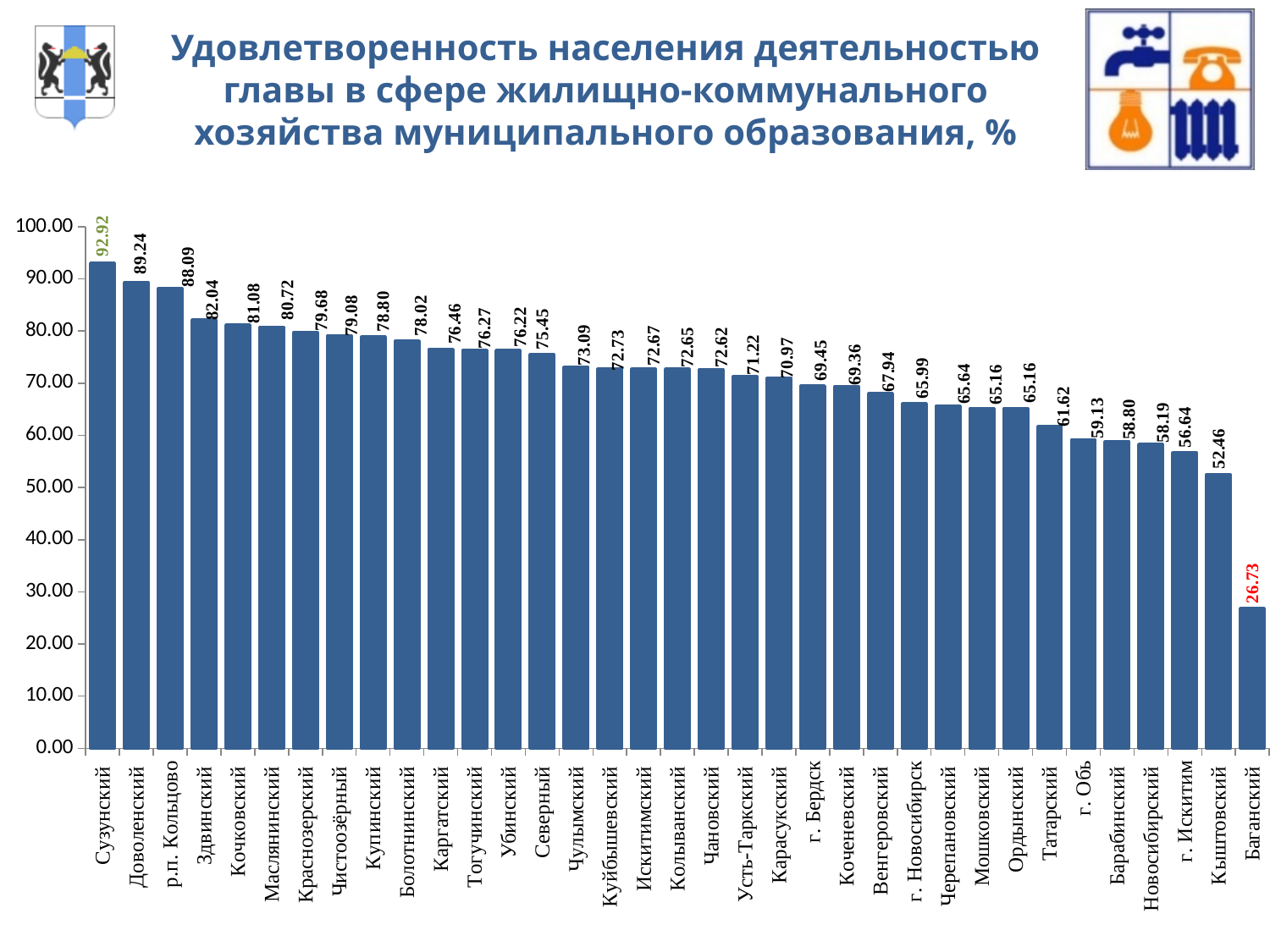
What kind of chart is shown on the slide? bar chart What is the difference between the values for Доволенский and р.п. Кольцово? 1.15 Do the values rise or fall from left to right along the x axis? fall Which is larger, the value for г. Бердск or the value for Татарский? г. Бердск What is the value for г. Новосибирск? 65.99 Is the value for Кыштовский greater or less than 60.00? less Which category has the highest value? Сузунский Which category has the lowest value? Баганский What is the difference between the values for Сузунский and Баганский? 66.19 What is the value for Сузунский? 92.92 How many categories are shown on the x axis? 35 What is the value for Баганский? 26.73